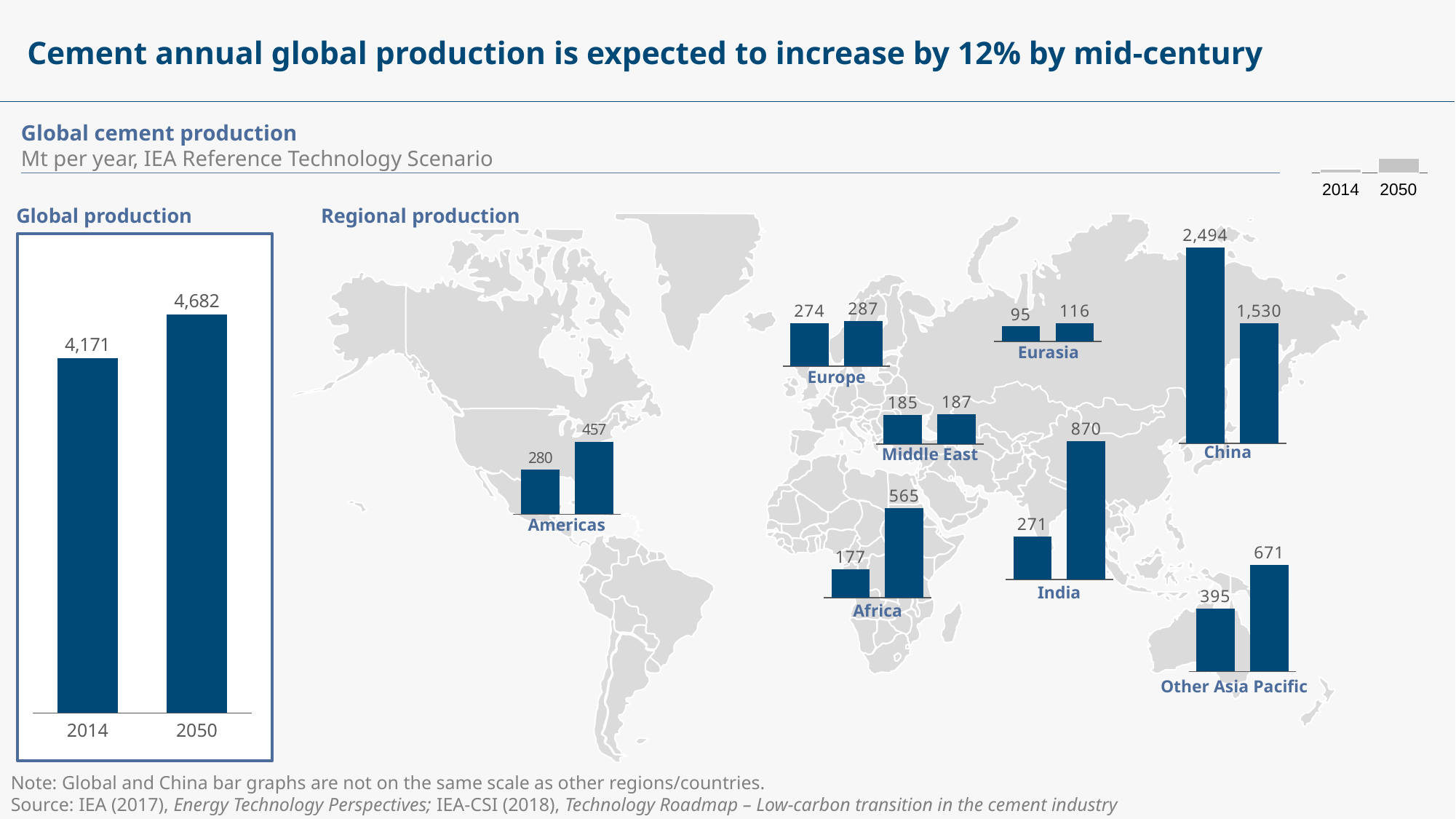
In the Regional production chart, is the 2050 value for Africa larger or smaller than the 2050 value for Americas? larger How many regions are shown in the Regional production chart? 8 In the Regional production chart, what is the 2050 value for India? 870 What kind of chart is the Global production chart? bar chart In the Regional production chart, what is the 2014 value for China? 2,494 In the Regional production chart, which region has the highest 2050 value? China In the Regional production chart, which region has the lowest 2014 value? Eurasia In the Regional production chart, what is the difference between the 2050 and 2014 values for Other Asia Pacific? 276 In the Regional production chart, does China's value rise or fall from 2014 to 2050? fall In the Global production chart, what is the value for 2050? 4,682 In the Global production chart, what is the difference between the 2050 and 2014 values? 511 In the Global production chart, what is the value for 2014? 4,171